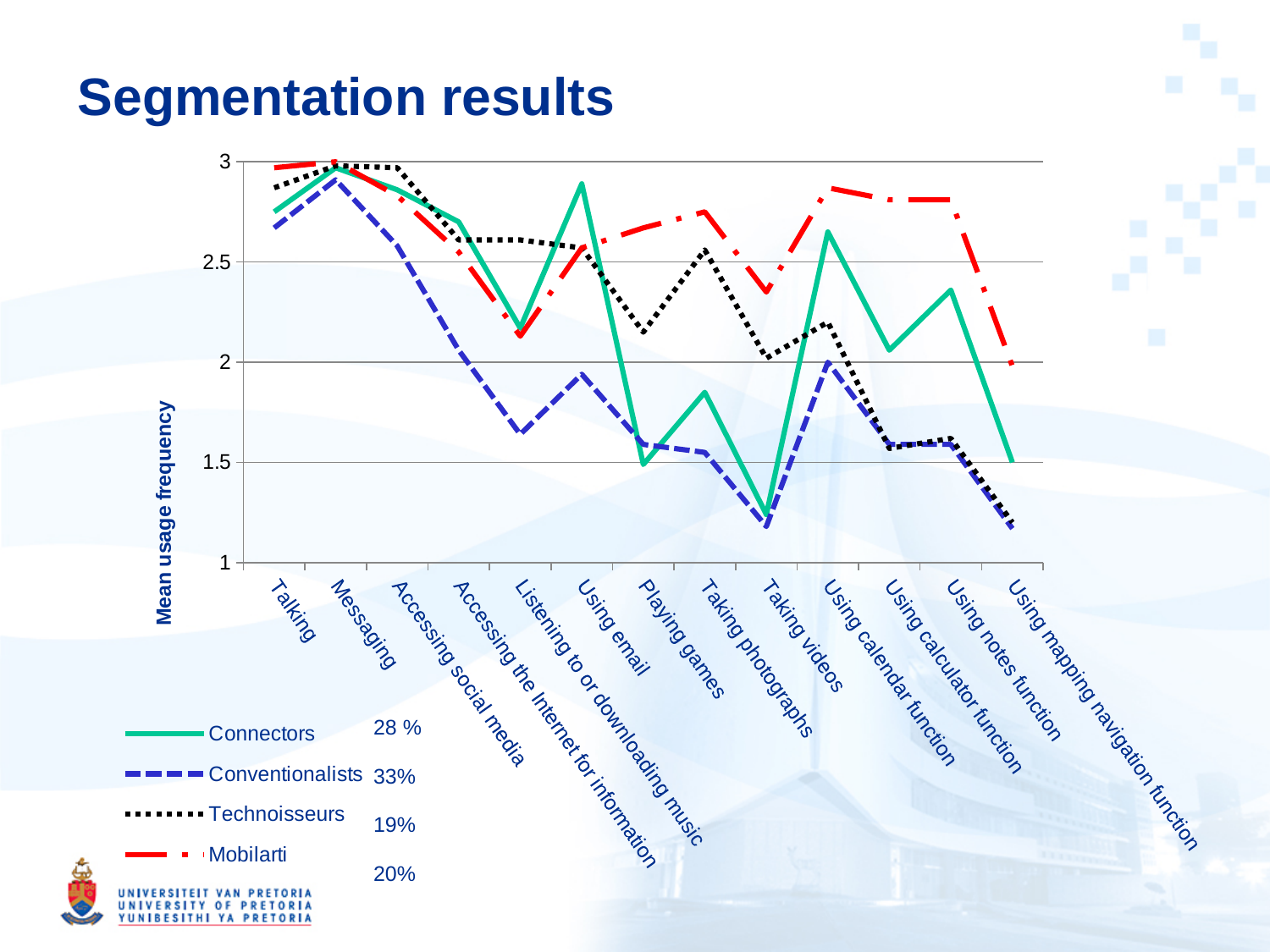
Is the value for Connectors at Using email greater or less than 2.5? greater Which series has the highest value at Using mapping navigation function? Mobilarti What kind of chart is shown on the slide? line chart At Playing games, which series has the higher value, Connectors or Mobilarti? Mobilarti Is the value for Technoisseurs at Using mapping navigation function greater or less than 1.5? less What percentage is shown next to Conventionalists in the legend? 33% At Using email, which series has the higher value, Connectors or Conventionalists? Connectors How many series does the legend list? 4 How many activity categories are plotted along the x axis? 13 Which series has the lowest value at Using email? Conventionalists Is the value for Mobilarti at Using calendar function greater or less than 2.5? greater